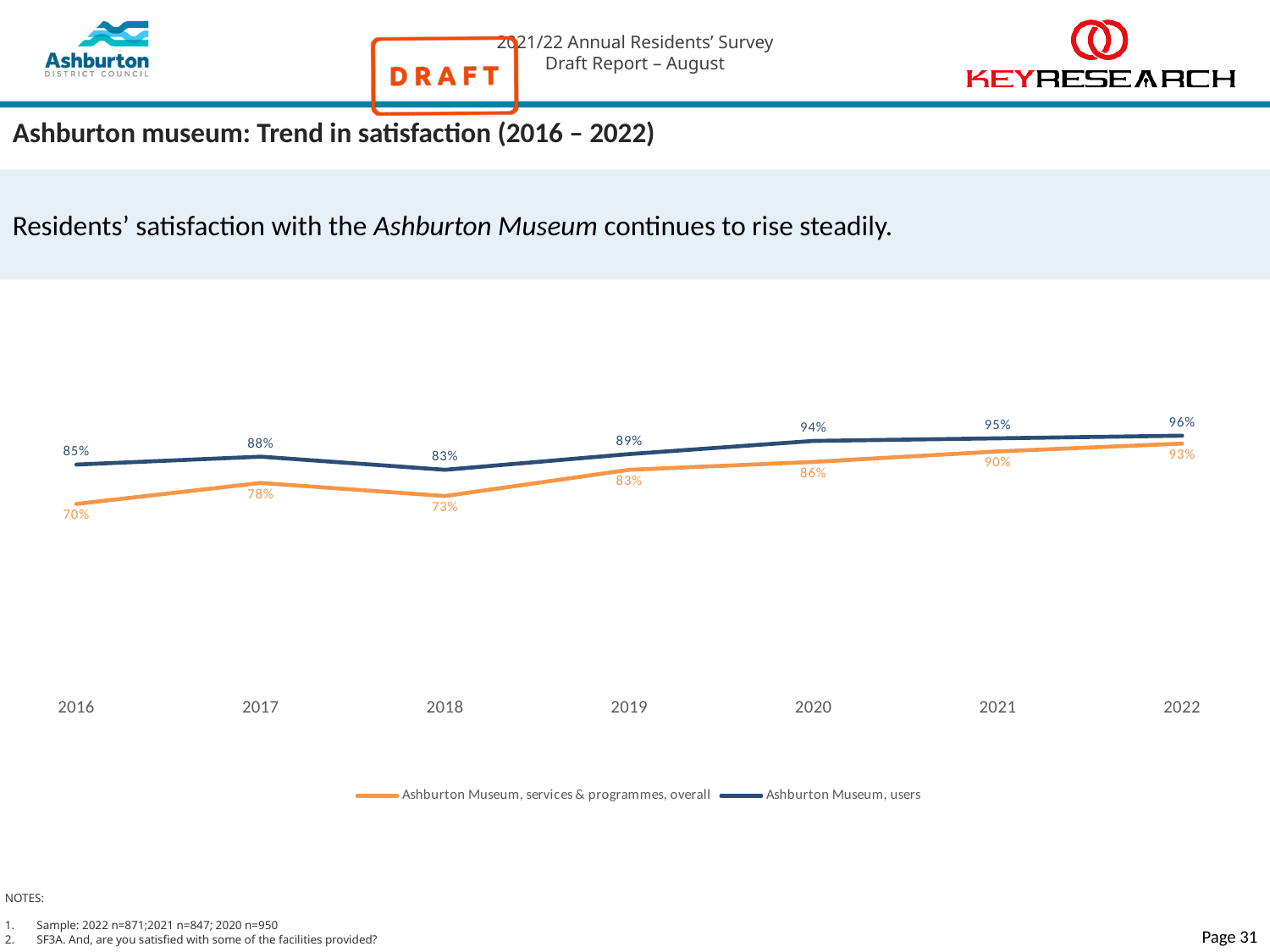
What is the value for Ashburton Museum, users in 2022? 96% How many years are plotted along the x axis? 7 Does the value for Ashburton Museum, services & programmes, overall rise or fall from 2018 to 2022? rise What is the value for Ashburton Museum, users in 2016? 85% How many series does the legend list? 2 In which year is the value for Ashburton Museum, users highest? 2022 Which series has the higher value in 2019? Ashburton Museum, users What is the value for Ashburton Museum, services & programmes, overall in 2018? 73% What is the difference between the two series in 2016? 15% What type of chart is shown on the slide? line chart In which year is the value for Ashburton Museum, services & programmes, overall lowest? 2016 What is the difference between the 2022 and 2016 values for Ashburton Museum, services & programmes, overall? 23%